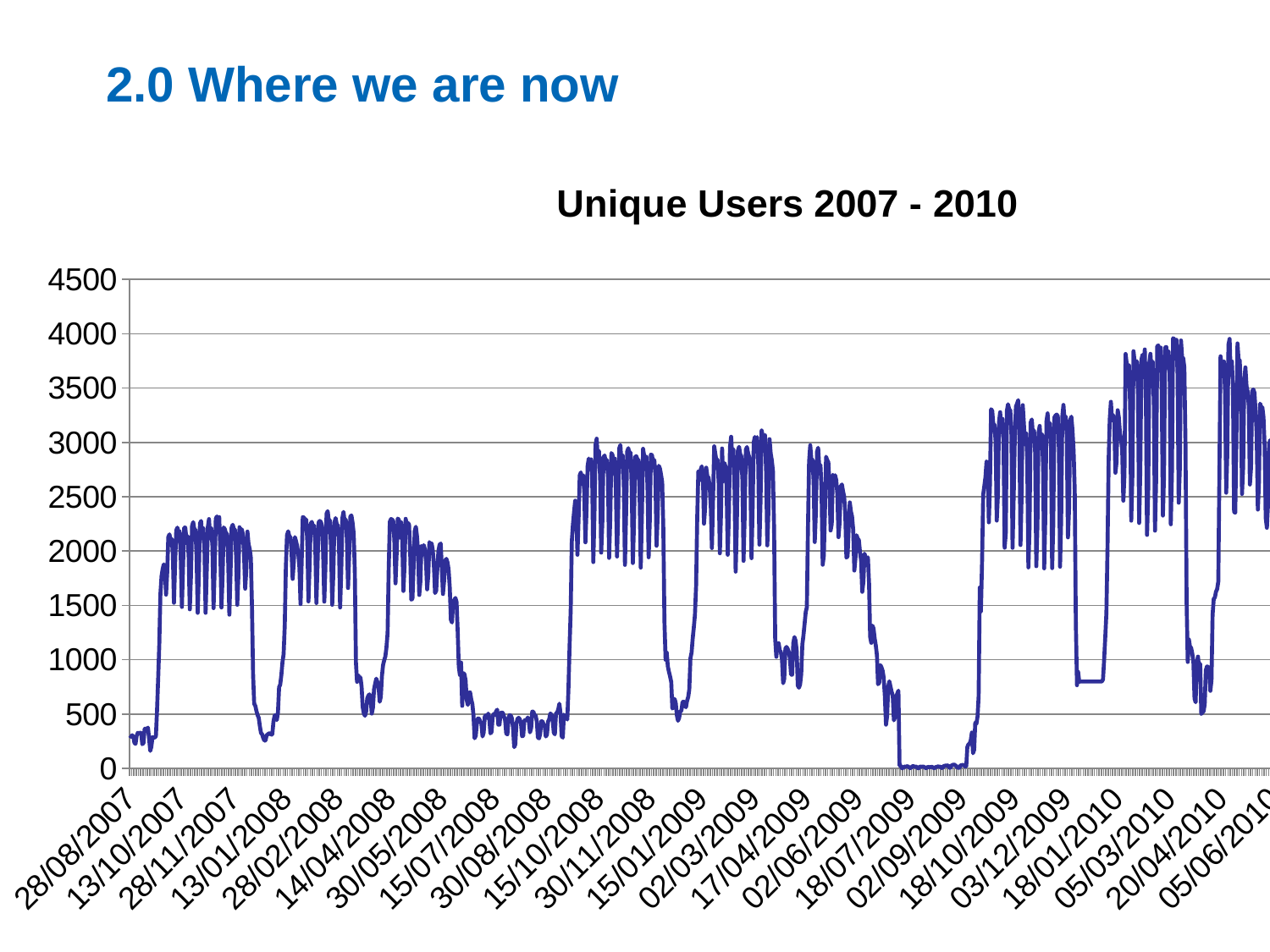
What kind of chart is shown on the slide? line chart Which is larger, the value at 28/08/2007 or the value at 05/06/2010? 05/06/2010 Do the peak levels of the line generally rise or fall from 2007 to 2010? rise Between which two date labels is the line flat at close to 0? 18/07/2009 and 02/09/2009 What is the highest value shown on the vertical axis? 4500 Is the value at 02/09/2009 greater or less than 500? less How many lines are plotted on the chart? 1 Is the value at 30/08/2008 greater or less than 1000? less Is the value at 28/08/2007 greater or less than 500? less What is the title of the chart? Unique Users 2007 - 2010